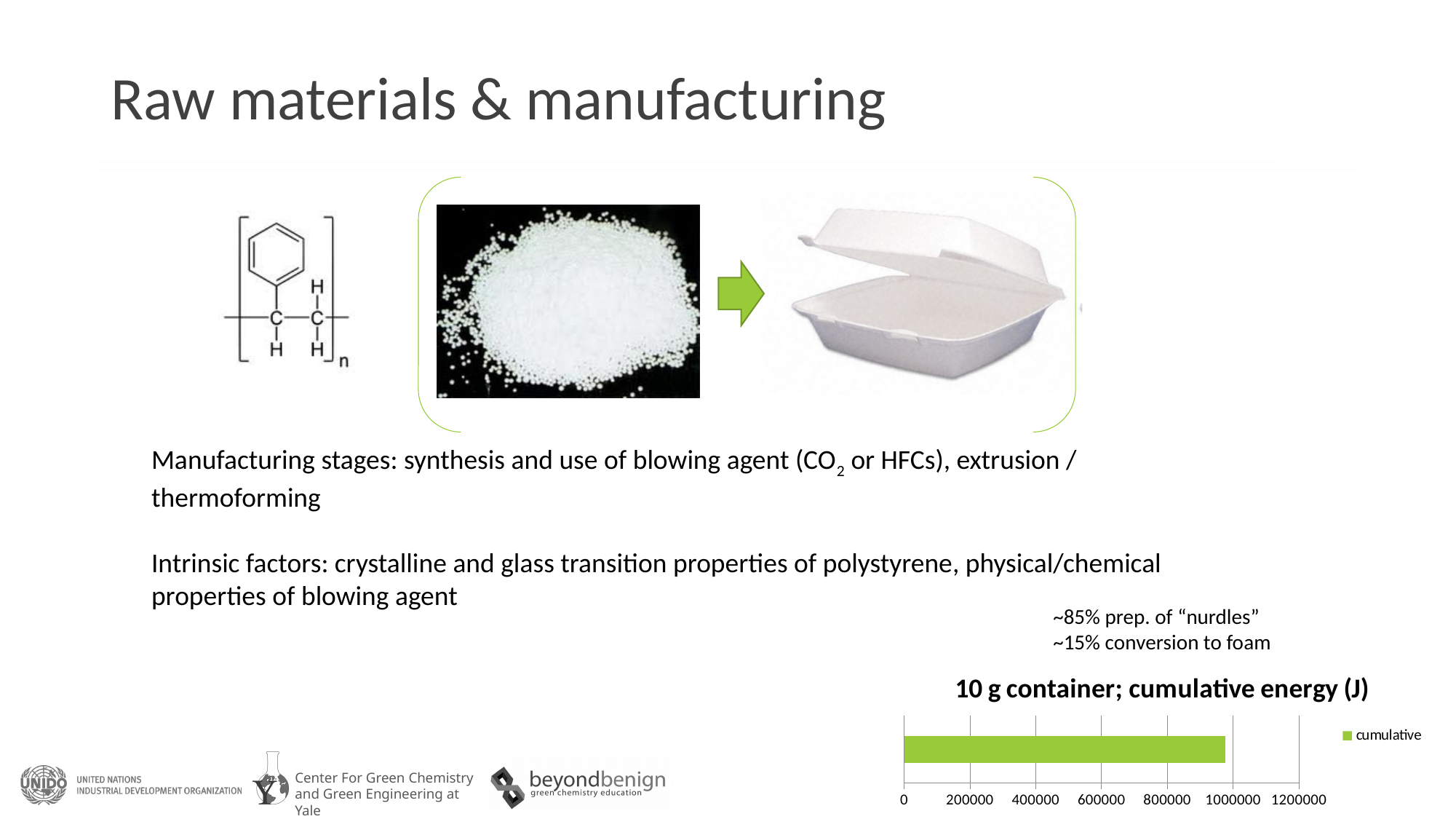
What kind of chart is shown on the slide? bar chart Is the value of the cumulative energy bar greater or less than 600000? greater What is the title of the chart on the slide? 10 g container; cumulative energy (J) How many bars are plotted in the chart? 1 How many series does the chart's legend list? 1 Is the value of the cumulative energy bar greater or less than 1200000? less What is the highest value shown on the chart's horizontal axis? 1200000 Is the value of the cumulative energy bar greater or less than 800000? greater What is the name of the series shown in the chart's legend? cumulative